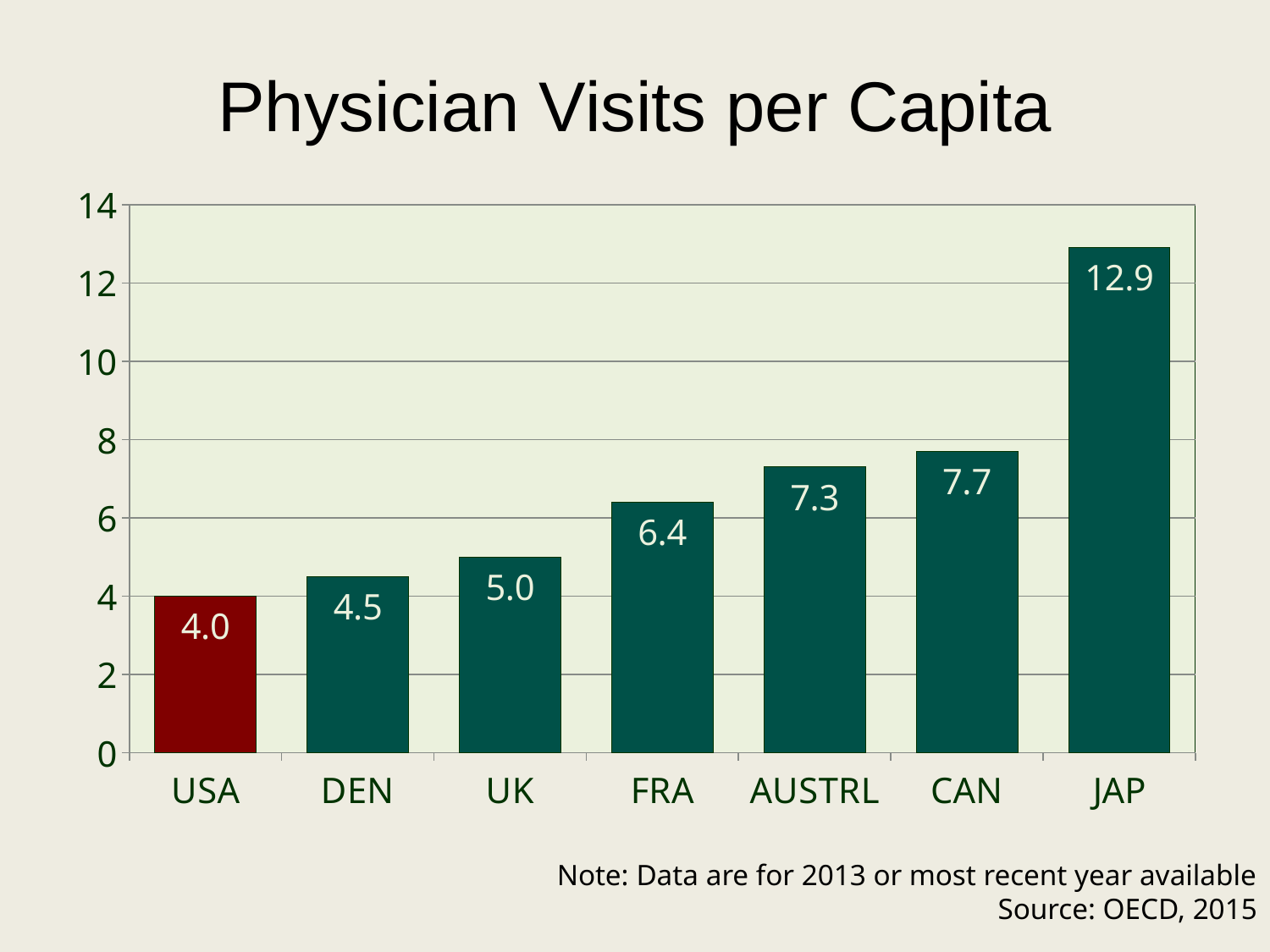
What is the value for USA? 4.0 Which is larger, the value for FRA or the value for DEN? FRA What kind of chart is this? bar chart How many countries are shown on the chart? 7 Which country has the lowest physician visits per capita? USA Is the value for CAN greater or less than 8? less Which bar is coloured differently from the others? USA What is the difference between the values for JAP and CAN? 5.2 What is the value for JAP? 12.9 What is the value for AUSTRL? 7.3 What is the difference between the values for UK and USA? 1.0 Which country has the highest physician visits per capita? JAP